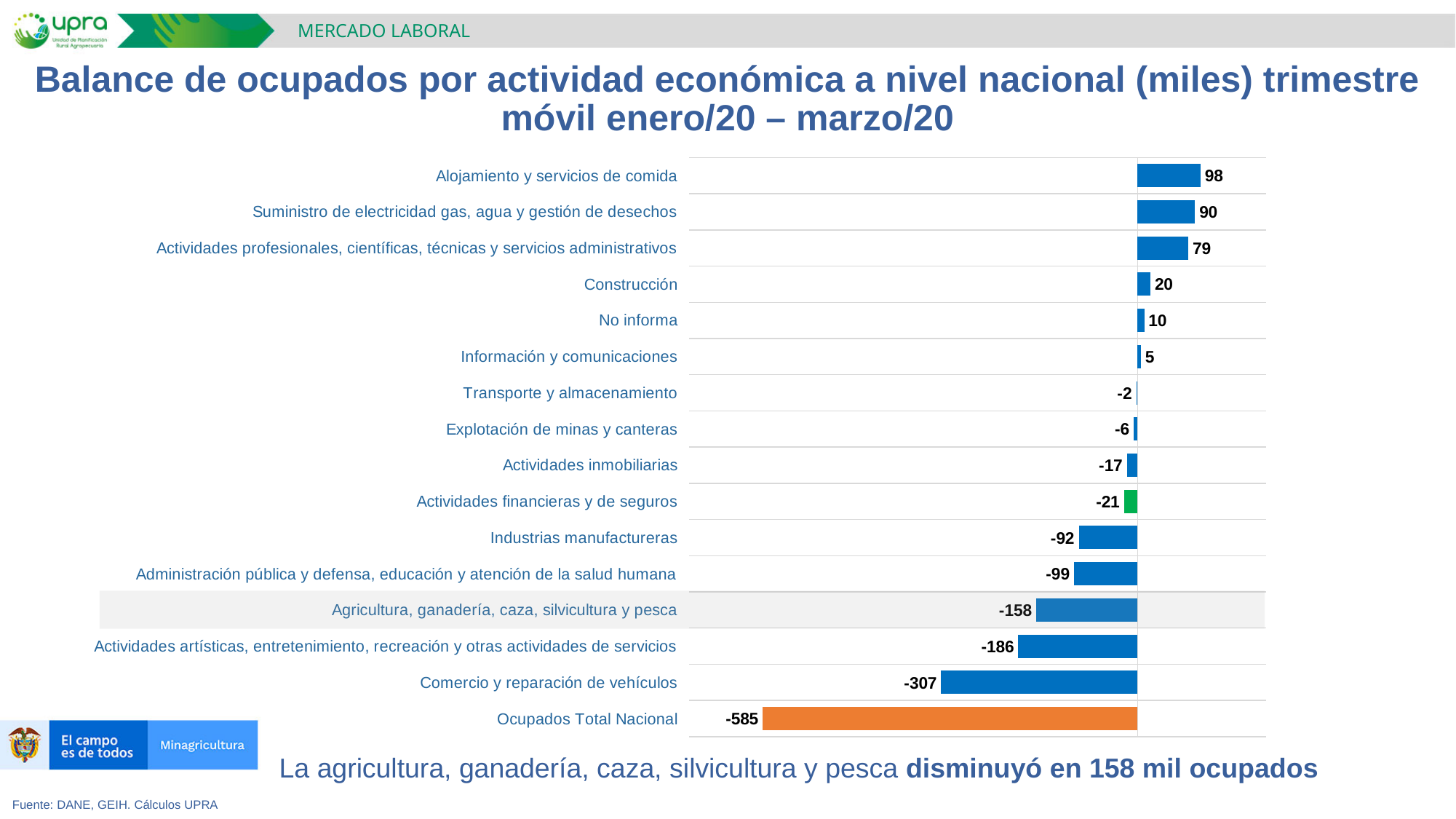
What is the value for Ocupados Total Nacional? -585 Which category has the lowest value? Ocupados Total Nacional What is the value for Alojamiento y servicios de comida? 98 Which category has the highest value? Alojamiento y servicios de comida What is the value for Agricultura, ganadería, caza, silvicultura y pesca? -158 What is the value for Actividades financieras y de seguros? -21 What is the value for Comercio y reparación de vehículos? -307 What kind of chart is shown on the slide? Bar chart What colour is the bar for Ocupados Total Nacional? Orange What is the difference between the values for Alojamiento y servicios de comida and Suministro de electricidad gas, agua y gestión de desechos? 8 How many categories are shown in the chart? 16 Which is larger, the value for Construcción or the value for No informa? Construcción